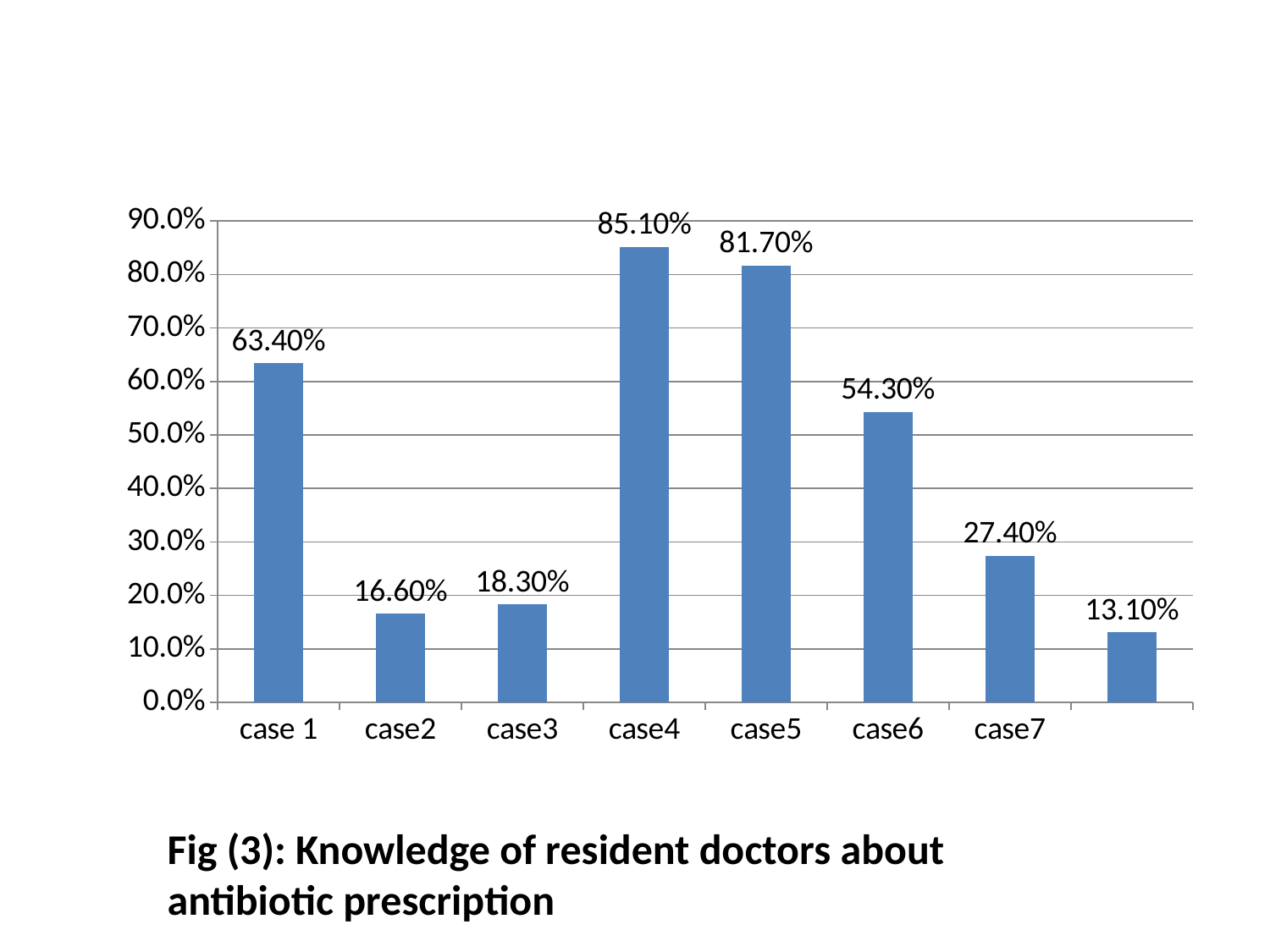
What is the caption of the figure on the slide? Fig (3): Knowledge of resident doctors about antibiotic prescription What is the lowest value shown on the chart? 13.10% What is the value for case6? 54.30% Which case has the highest value? case4 Is the value for case7 greater or less than 30%? less What kind of chart is shown on the slide? bar chart What is the value for case4? 85.10% What is the difference between the values for case 1 and case6? 9.10% What is the value for case 1? 63.40% What is the difference between the values for case4 and case5? 3.40% Which is larger, the value for case6 or the value for case7? case6 What is the value for case2? 16.60%